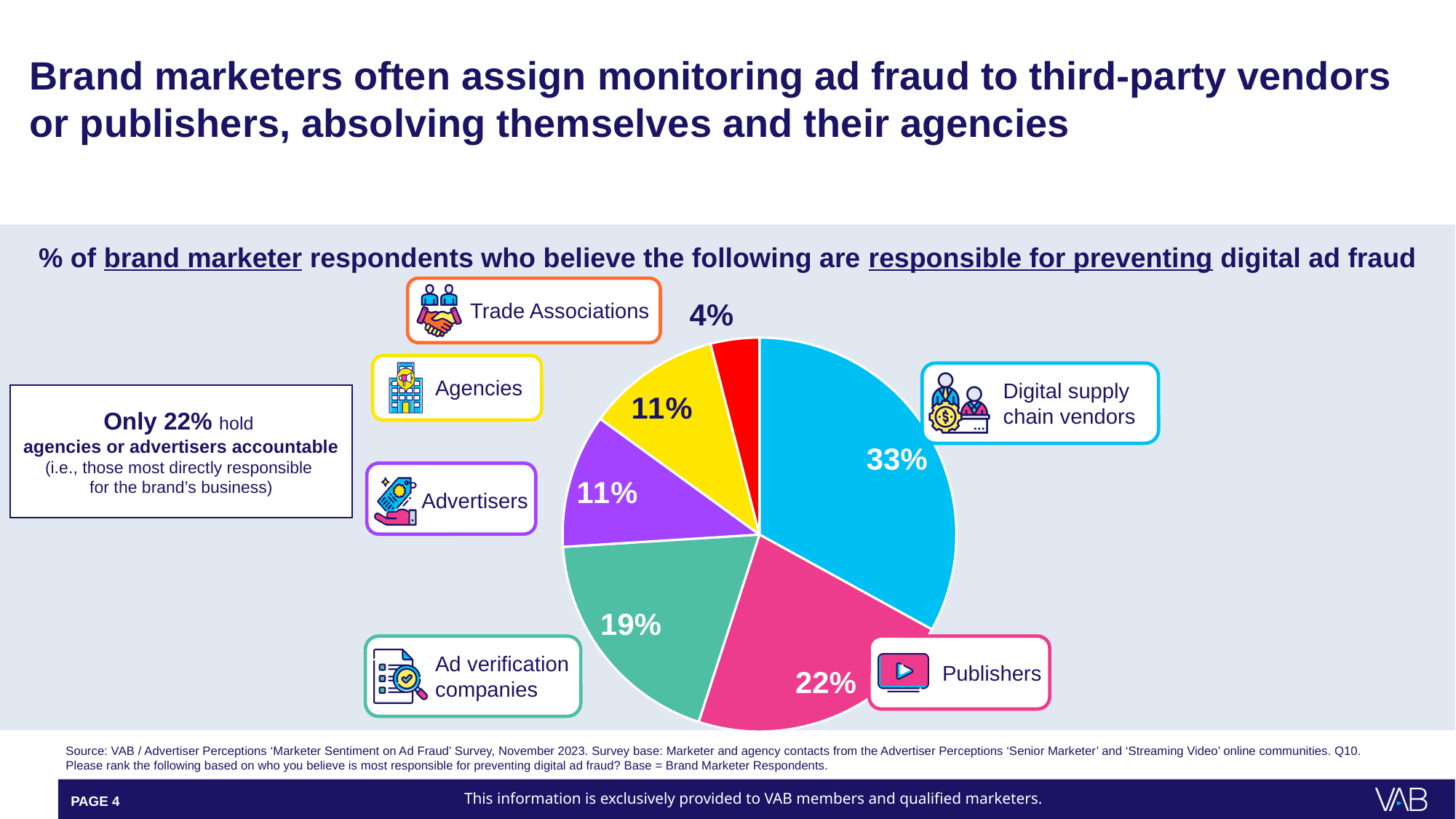
What kind of chart is shown on the slide? Pie chart What percentage of respondents believe trade associations are responsible for preventing digital ad fraud? 4% What percentage of respondents believe ad verification companies are responsible for preventing digital ad fraud? 19% What percentage of respondents believe publishers are responsible for preventing digital ad fraud? 22% What percentage of brand marketer respondents believe digital supply chain vendors are responsible for preventing digital ad fraud? 33% Which is larger: the share for publishers or the share for ad verification companies? Publishers What is the combined percentage for advertisers and agencies? 22% What colour is the slice representing publishers? Pink How many slices does the pie chart have? 6 Which group has the largest share of the pie chart? Digital supply chain vendors Which group has the smallest share of the pie chart? Trade Associations What is the difference in percentage points between digital supply chain vendors and publishers? 11